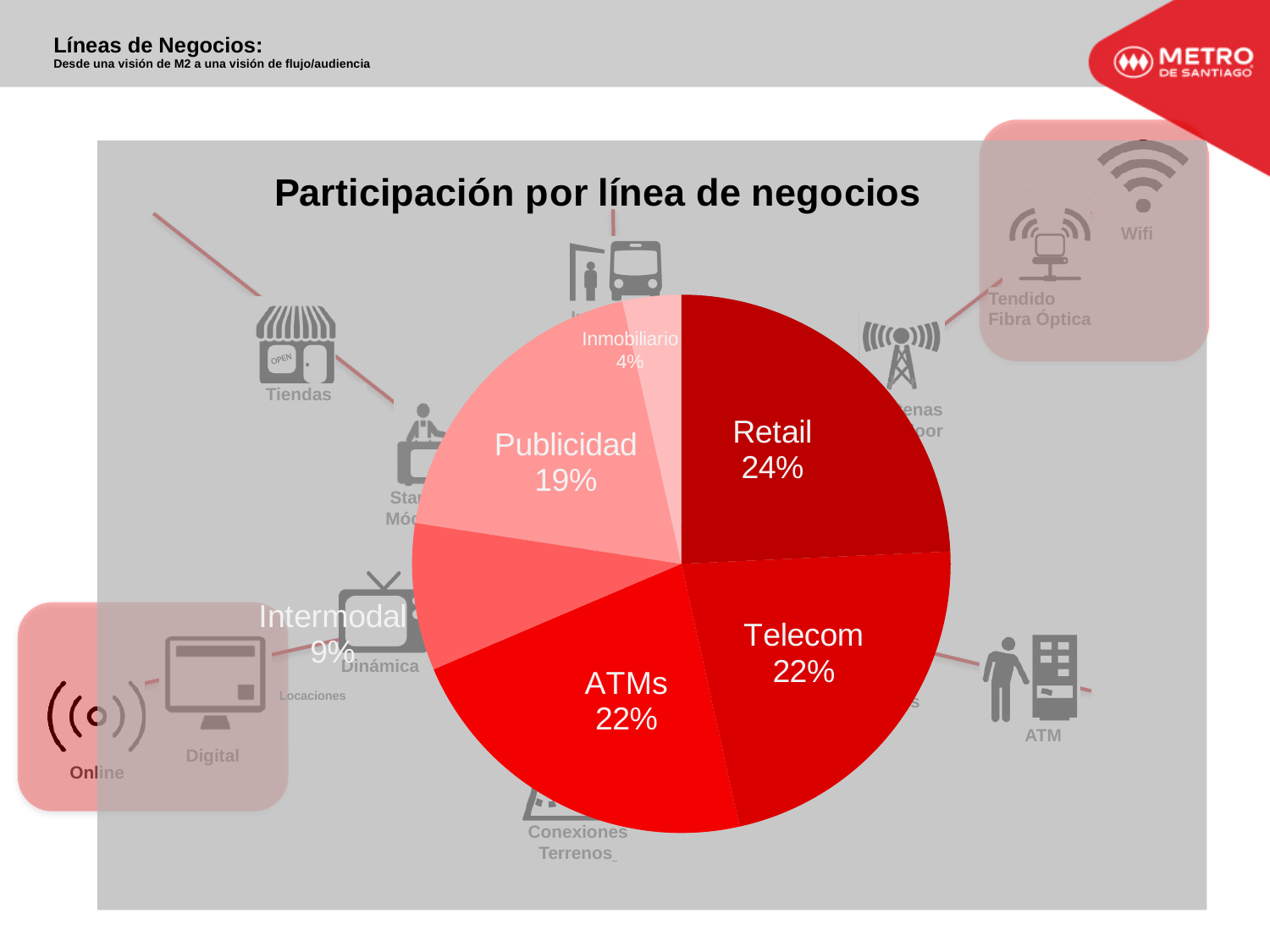
What is the combined share of Telecom and ATMs? 44% What share does Publicidad have in the pie chart? 19% What type of chart is shown on the slide? Pie chart What share does Inmobiliario have in the pie chart? 4% Which business line has the smallest share in the pie chart? Inmobiliario What is the difference in percentage points between Retail and Publicidad? 5 Which has a larger share, Publicidad or Intermodal? Publicidad What share does Intermodal have in the pie chart? 9% What is the title of the chart? Participación por línea de negocios Which business line has the largest share in the pie chart? Retail How many slices does the pie chart have? 6 What share does Retail have in the pie chart? 24%